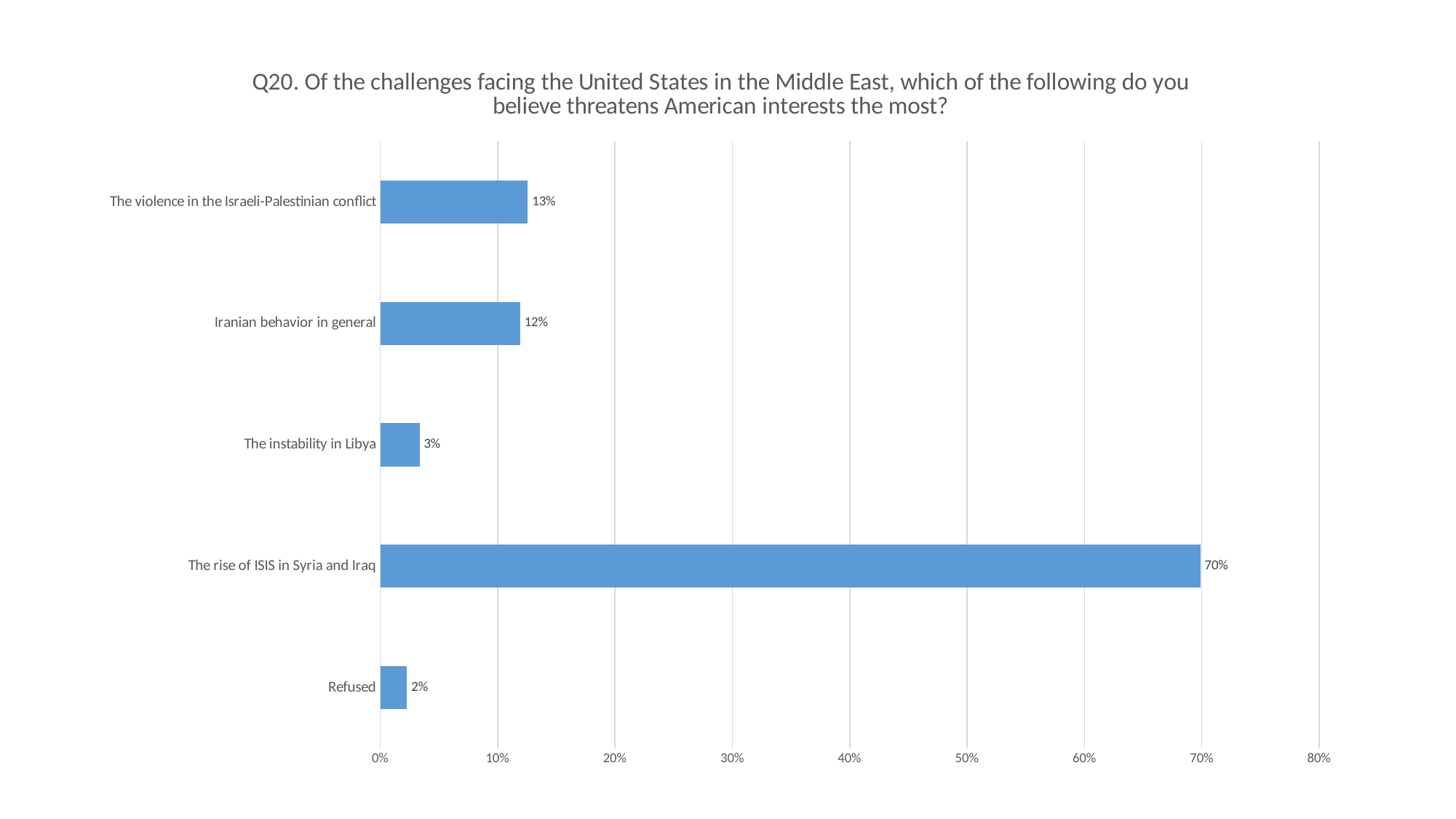
What kind of chart is shown on the slide? Bar chart Which is larger: the value for 'The instability in Libya' or the value for 'Iranian behavior in general'? Iranian behavior in general What is the value for 'The instability in Libya'? 3% Which category has the highest value? The rise of ISIS in Syria and Iraq What percentage of respondents chose 'The rise of ISIS in Syria and Iraq'? 70% What is the difference between the value for 'The rise of ISIS in Syria and Iraq' and the value for 'The violence in the Israeli-Palestinian conflict'? 57% Is the value for 'The rise of ISIS in Syria and Iraq' greater or less than 50%? greater Which category has the lowest value? Refused What percentage is shown for 'Refused'? 2% How many categories are shown in the chart? 5 What is the value for 'The violence in the Israeli-Palestinian conflict'? 13% What is the value for 'Iranian behavior in general'? 12%